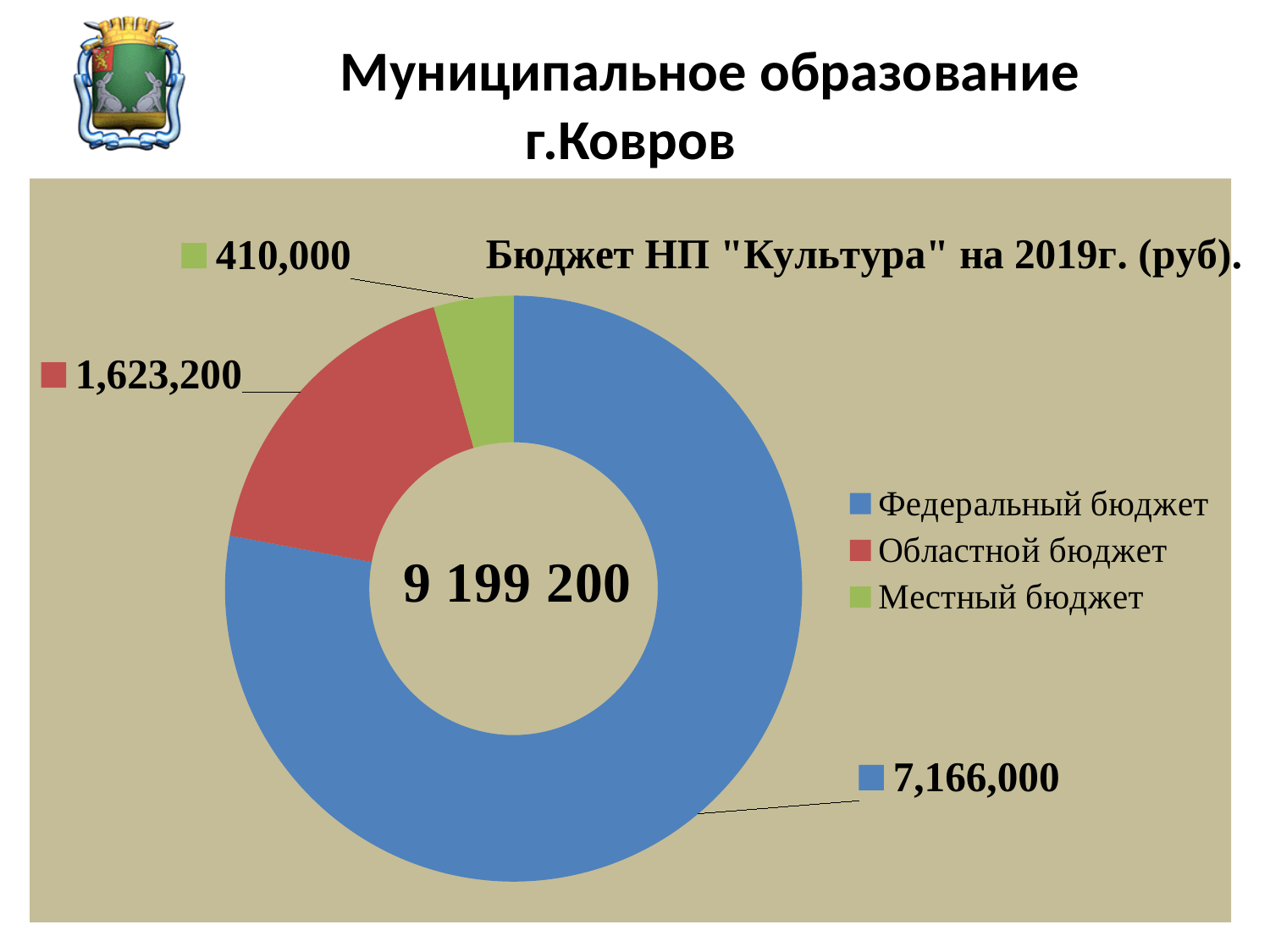
Which budget source has the smallest slice in the chart? Местный бюджет What is the value for Федеральный бюджет in the chart? 7,166,000 What kind of chart is shown on the slide? Doughnut (pie) chart What is the value for Местный бюджет in the chart? 410,000 What is the title of the chart? Бюджет НП "Культура" на 2019г. (руб). What is the value for Областной бюджет in the chart? 1,623,200 Which budget source has the largest slice in the chart? Федеральный бюджет What is the difference between the Федеральный бюджет and Областной бюджет values? 5,542,800 What is the difference between the Областной бюджет and Местный бюджет values? 1,213,200 Which is larger, Областной бюджет or Местный бюджет? Областной бюджет How many slices does the chart have? 3 What total value is shown in the centre of the chart? 9 199 200